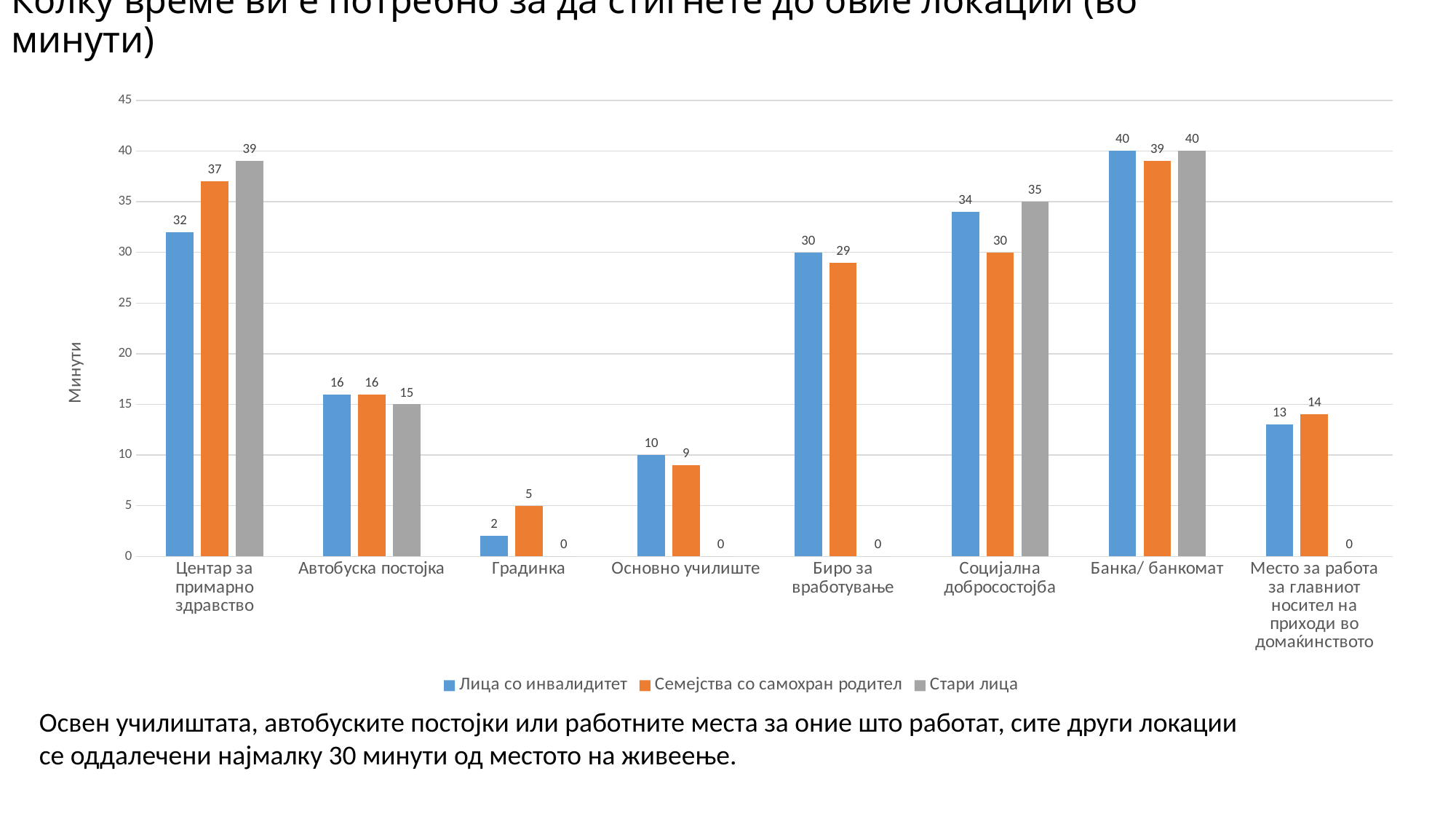
What is the value for Лица со инвалидитет at Центар за примарно здравство? 32 What is the value for Семејства со самохран родител at Биро за вработување? 29 Which is larger at Социјална добросостојба: the value for Лица со инвалидитет or for Семејства со самохран родител? Лица со инвалидитет Which series is shown in orange in the legend? Семејства со самохран родител What kind of chart is shown on the slide? Bar chart Which category has the highest value for Лица со инвалидитет? Банка/ банкомат What is the difference between the Стари лица and Лица со инвалидитет values at Центар за примарно здравство? 7 What is the value for Стари лица at Социјална добросостојба? 35 How many series does the legend list? 3 How many categories are shown on the x axis? 8 What is the label of the y axis? Минути Which category has the lowest value for Семејства со самохран родител? Градинка